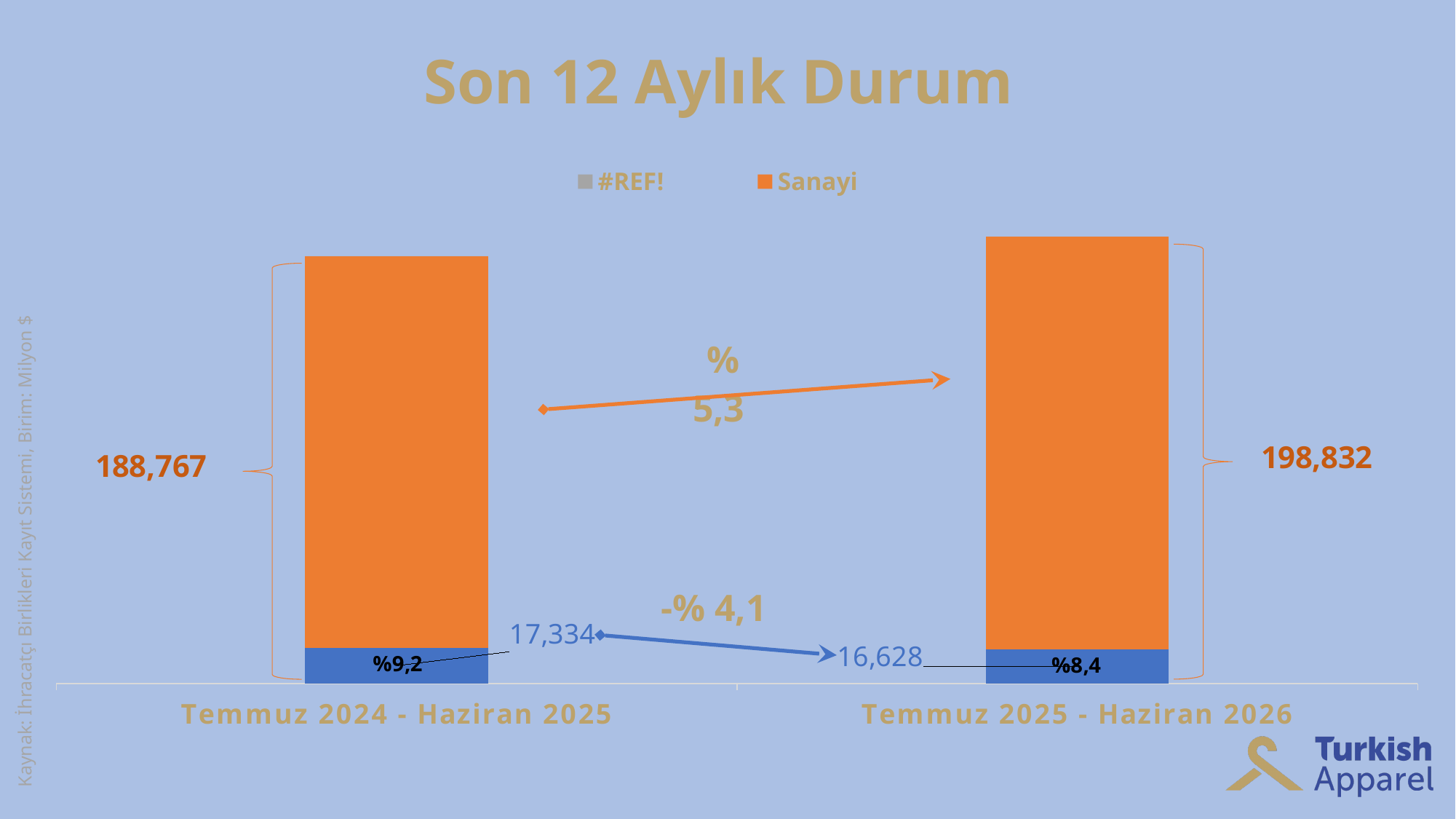
Which period has the higher total value? Temmuz 2025 - Haziran 2026 What percentage change is written next to the orange arrow between the two bars? % 5,3 What percentage change is written next to the blue arrow between the two bars? -% 4,1 What is the title of the chart? Son 12 Aylık Durum What kind of chart is shown on the slide? bar chart How many series does the legend list? 2 What is the difference between the total values of the two periods (198,832 and 188,767)? 10,065 What value is labelled for the blue segment of the Temmuz 2024 - Haziran 2025 bar? 17,334 What value is labelled for the blue segment of the Temmuz 2025 - Haziran 2026 bar? 16,628 How many periods (categories) are shown on the x axis? 2